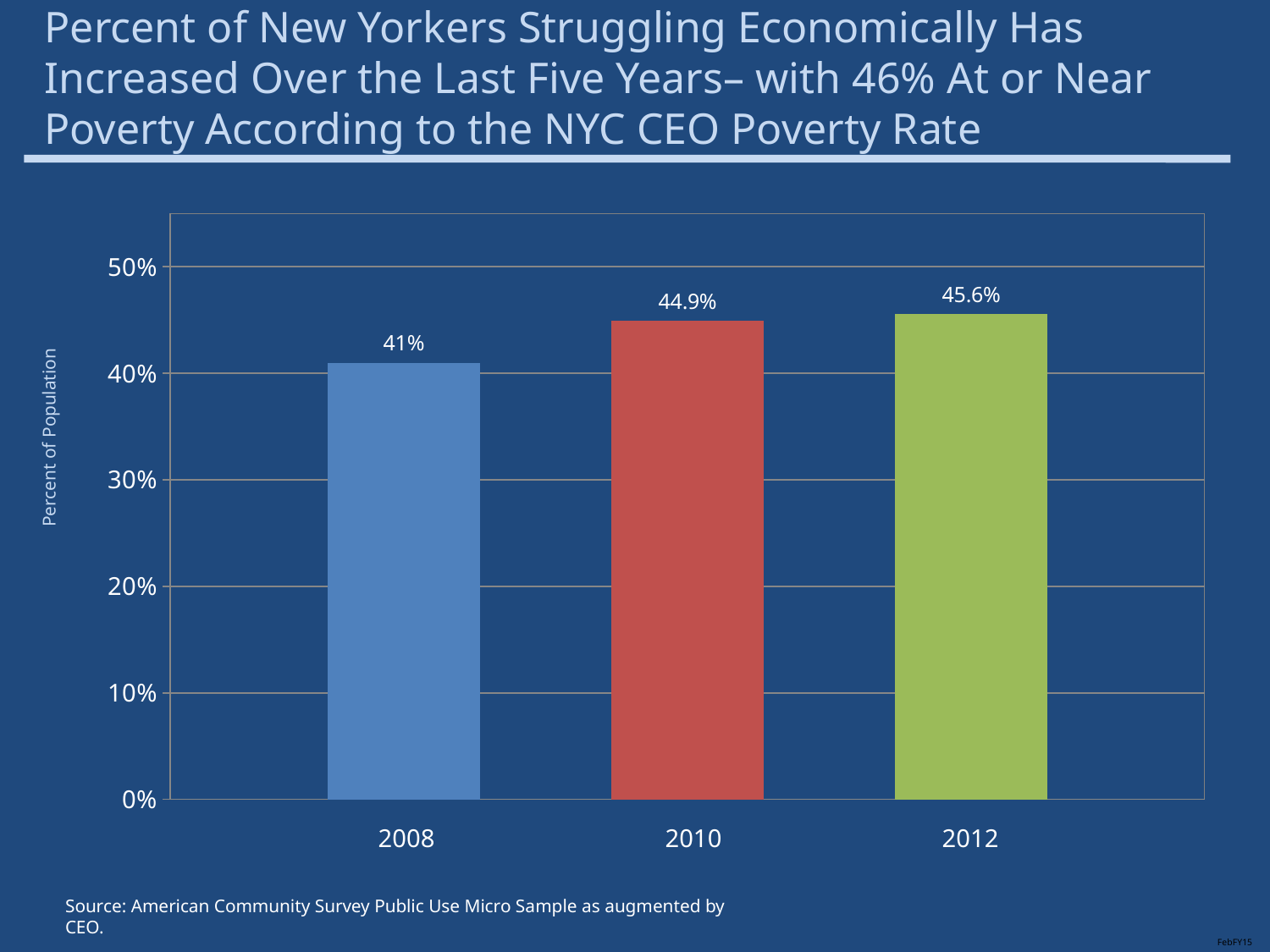
Is the value for 2008 greater or less than 40%? greater What is the value for 2008? 41% Do the values rise or fall from 2008 to 2012? rise How many years are shown on the x axis? 3 What is the value for 2010? 44.9% Which year has the lowest value? 2008 Which is larger, the value for 2008 or the value for 2010? 2010 What kind of chart is shown on the slide? bar chart Which year has the highest value? 2012 What is the difference between the values for 2010 and 2008? 3.9% What is the difference between the values for 2012 and 2008? 4.6% What is the value for 2012? 45.6%